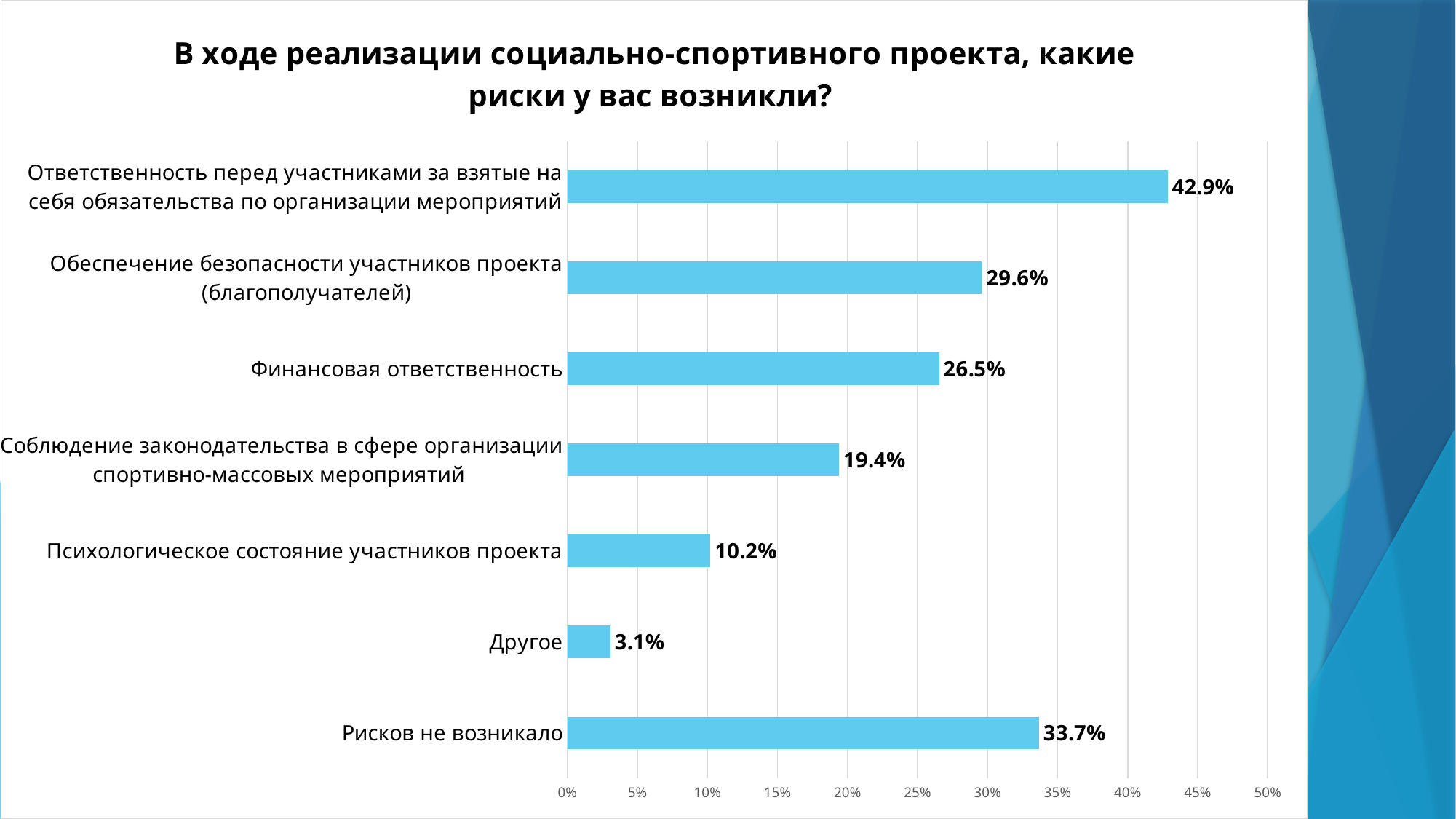
What is the value for "Психологическое состояние участников проекта"? 10.2% What is the value for "Рисков не возникало"? 33.7% Is the value for "Соблюдение законодательства в сфере организации спортивно-массовых мероприятий" greater or less than 20%? less What is the difference between the values for "Обеспечение безопасности участников проекта (благополучателей)" and "Финансовая ответственность"? 3.1% What is the value for "Другое"? 3.1% Which is larger: the value for "Рисков не возникало" or the value for "Обеспечение безопасности участников проекта (благополучателей)"? Рисков не возникало What kind of chart is shown on the slide? bar chart How many categories are shown in the chart? 7 What is the value for "Финансовая ответственность"? 26.5% What is the title of the chart? В ходе реализации социально-спортивного проекта, какие риски у вас возникли? Which category has the highest value? Ответственность перед участниками за взятые на себя обязательства по организации мероприятий Which category has the lowest value? Другое